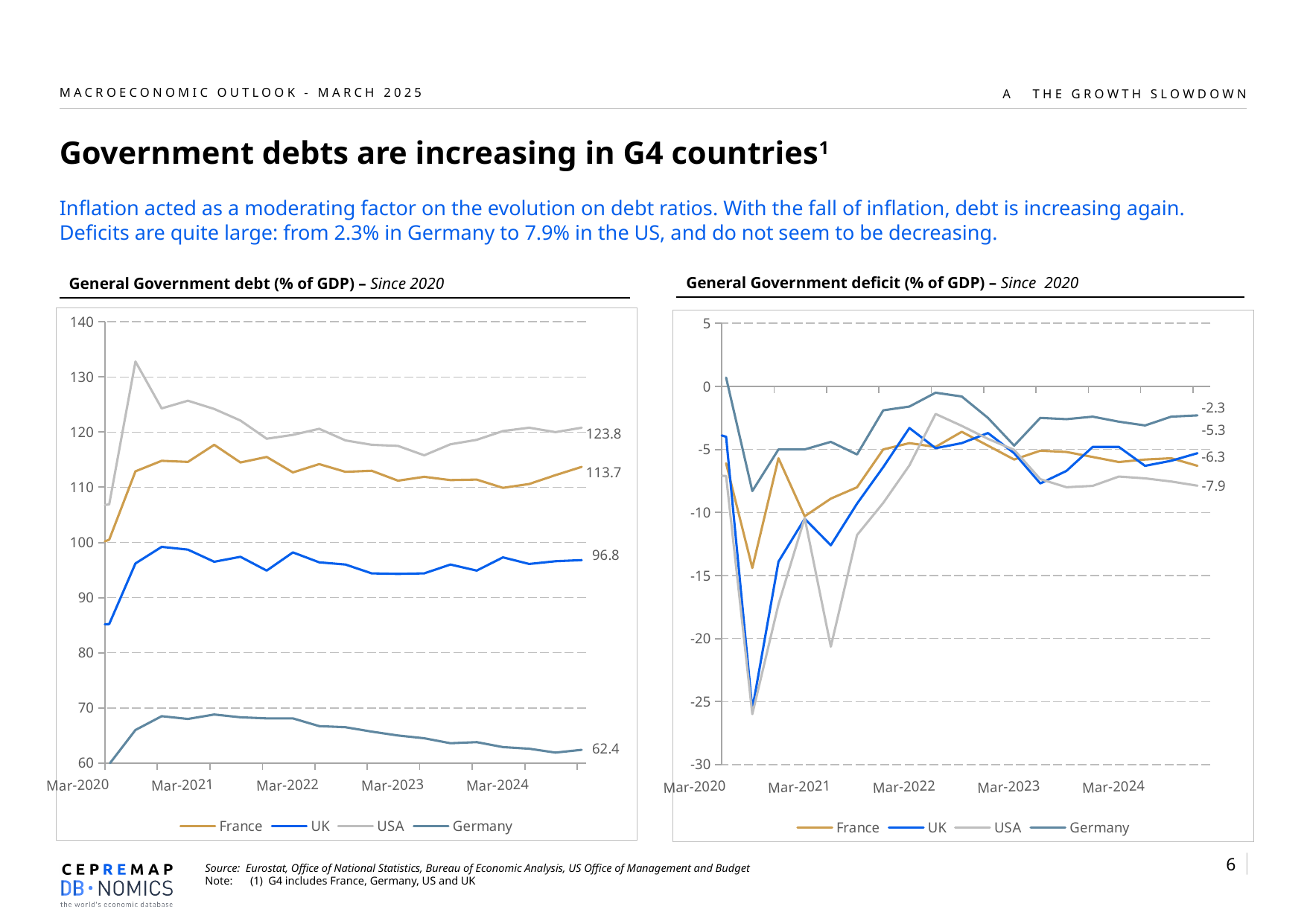
In the 'General Government deficit (% of GDP)' chart, which country has the largest deficit (lowest value) at the end of the series? USA In the 'General Government debt (% of GDP)' chart, what is the latest value shown for the USA? 123.8 In the 'General Government debt (% of GDP)' chart, is the UK's debt ratio at the end of the series greater or less than 100? less In the 'General Government deficit (% of GDP)' chart, is the latest value for the UK higher or lower than the latest value for France? higher What kind of chart is the 'General Government debt (% of GDP)' chart? line chart In the 'General Government debt (% of GDP)' chart, does Germany's debt ratio rise or fall from Mar-2021 to the end of the series? fall In the 'General Government deficit (% of GDP)' chart, what is the latest value shown for the USA? -7.9 In the 'General Government debt (% of GDP)' chart, what is the latest value shown for Germany? 62.4 In the 'General Government debt (% of GDP)' chart, what is the difference between the latest values for France and the UK? 16.9 In the 'General Government deficit (% of GDP)' chart, what is the latest value shown for Germany? -2.3 How many series does the legend of the 'General Government debt (% of GDP)' chart list? 4 In the 'General Government debt (% of GDP)' chart, which country has the lowest debt ratio at the end of the series? Germany